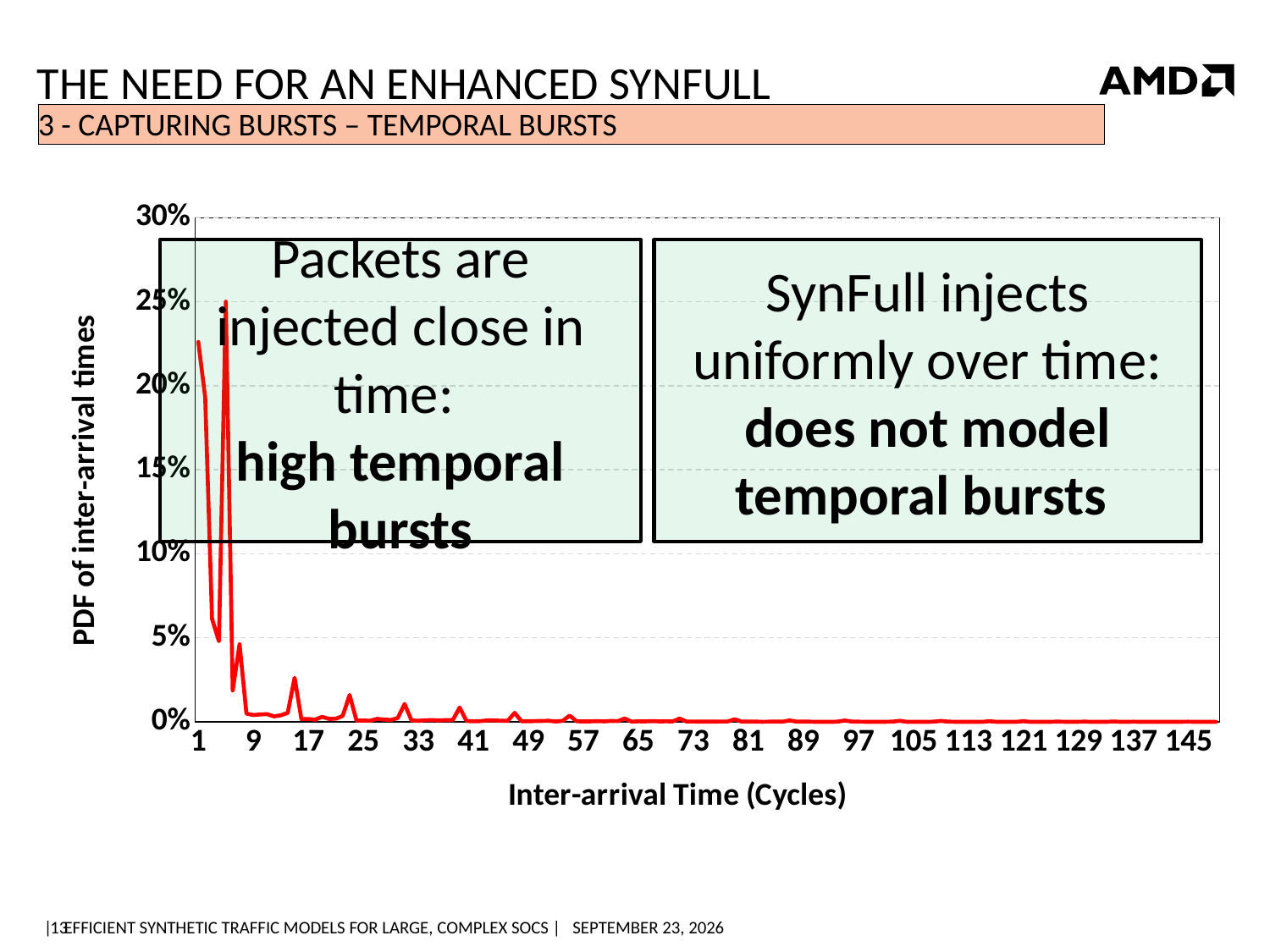
What kind of chart is shown on the slide? line chart Is the value at inter-arrival time 9 greater or less than 5%? less Is the value at inter-arrival time 145 greater or less than 5%? less How many tick labels are shown on the x axis? 19 What is the title of the x axis of the chart? Inter-arrival Time (Cycles) Is the value at inter-arrival time 1 greater or less than 20%? greater What is the highest value shown on the y axis? 30% What is the last inter-arrival time label shown on the x axis? 145 Overall, do the values rise or fall as the inter-arrival time increases along the x axis? fall